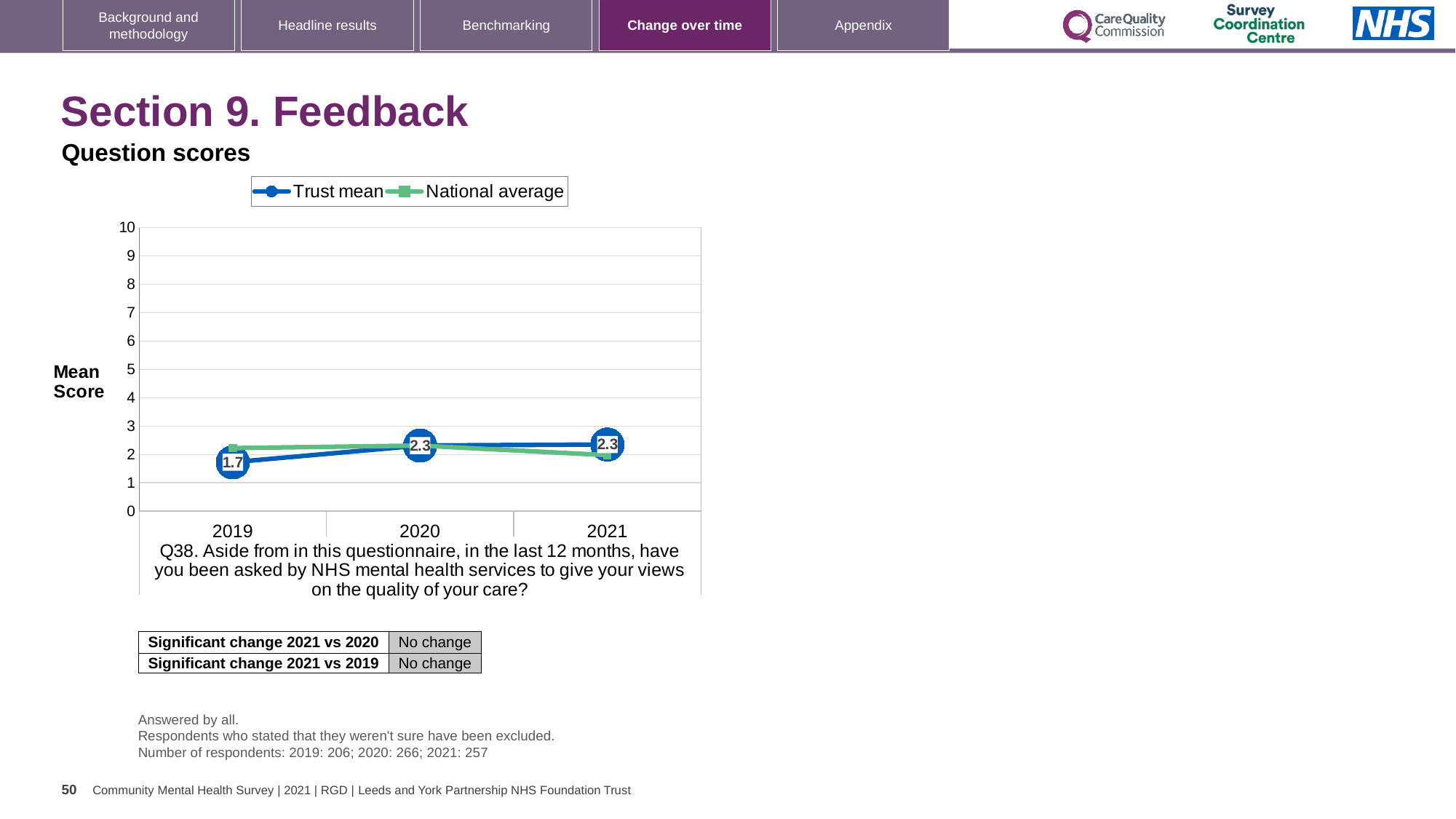
In 2019, which is higher: the Trust mean or the National average? National average What is the Trust mean score for 2020? 2.3 What is the difference between the Trust mean score in 2020 and in 2019? 0.6 In 2021, which is higher: the Trust mean or the National average? Trust mean What is the Trust mean score for 2019? 1.7 How many years are plotted on the x axis? 3 What kind of chart is shown? Line chart In which year is the Trust mean score lowest? 2019 Is the National average value for 2020 greater or less than 3? less How many series does the legend list? 2 What is the Trust mean score for 2021? 2.3 Does the Trust mean rise or fall from 2019 to 2020? Rise